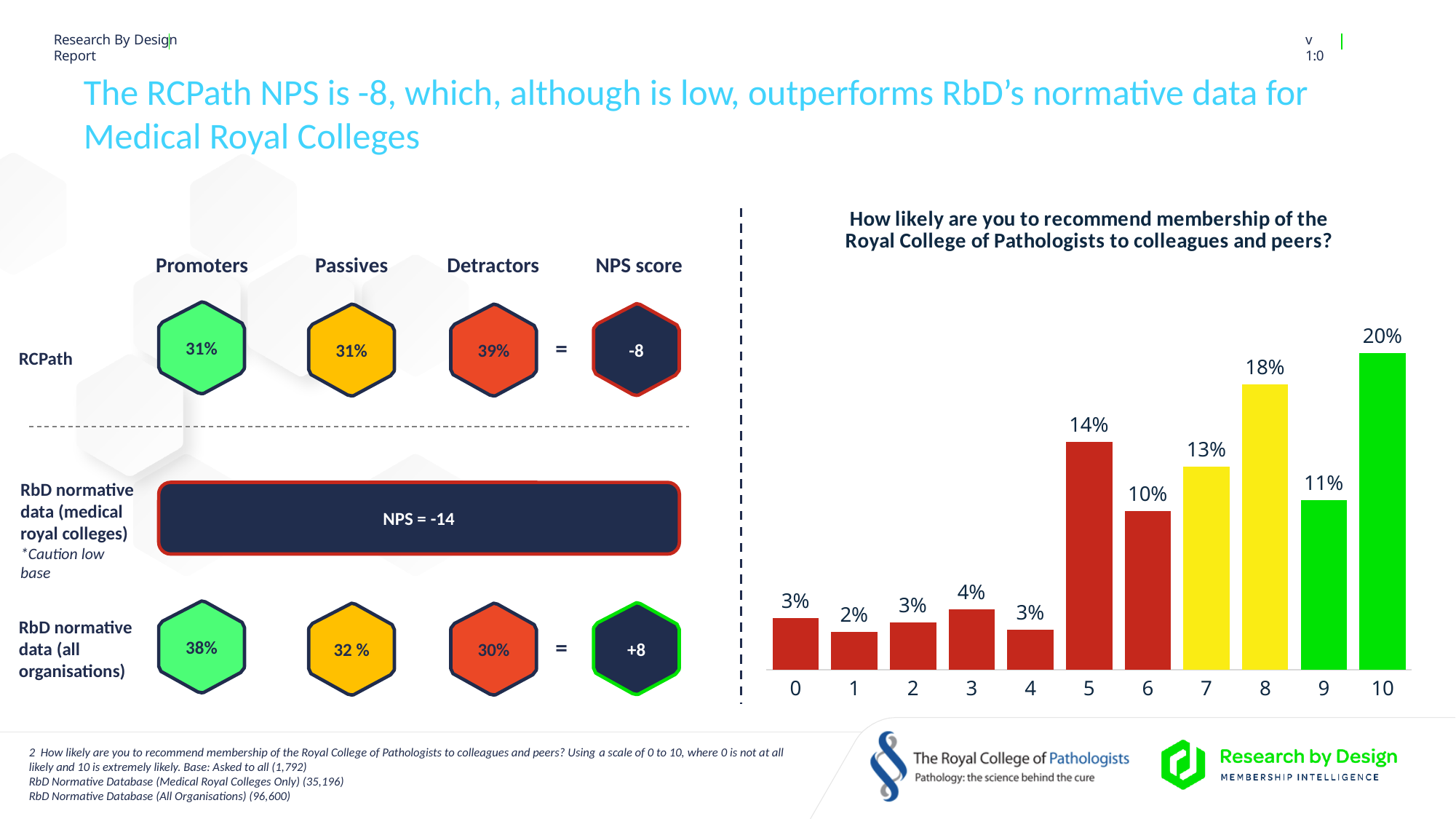
What is the title of the bar chart? How likely are you to recommend membership of the Royal College of Pathologists to colleagues and peers? Which score has the highest value in the bar chart? 10 What is the value for score 5 in the bar chart? 14% How many score categories are shown on the x axis of the bar chart? 11 What is the value for score 10 in the bar chart? 20% What is the value for score 8 in the bar chart? 18% What colour are the bars for scores 9 and 10 in the bar chart? green Which score has the lowest value in the bar chart? 1 What is the value for score 1 in the bar chart? 2% Which has the larger value in the bar chart, score 5 or score 7? score 5 What kind of chart is shown on the right side of the slide? bar chart What is the difference between the values for score 10 and score 8 in the bar chart? 2%